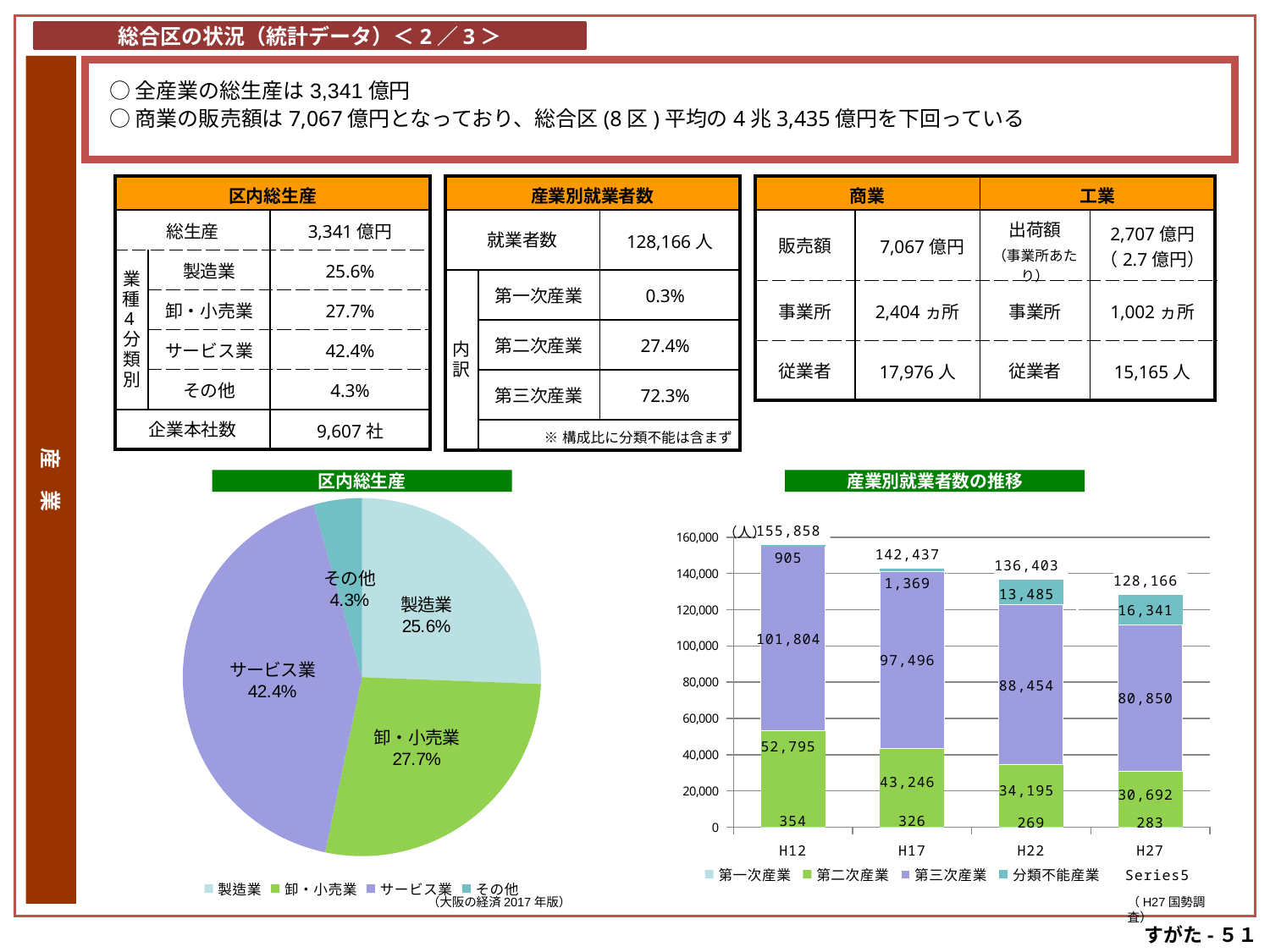
In the pie chart titled 区内総生産, which category has the largest share? サービス業 In the chart titled 産業別就業者数の推移, what is the difference between the 分類不能産業 values for H27 and H22? 2,856 In the pie chart titled 区内総生産, what share does サービス業 have? 42.4% In the chart titled 産業別就業者数の推移, what is the total for H17? 142,437 In the chart titled 産業別就業者数の推移, what is the value for 第三次産業 in H22? 88,454 In the chart titled 産業別就業者数の推移, do the total values rise or fall from H12 to H27? Fall In the pie chart titled 区内総生産, which category has the smallest share? その他 In the chart titled 産業別就業者数の推移, which is larger: 第二次産業 in H12 or 第二次産業 in H27? 第二次産業 in H12 What kind of chart is the chart titled 産業別就業者数の推移? Stacked bar chart In the chart titled 産業別就業者数の推移, how many series does the legend list? 5 In the pie chart titled 区内総生産, what is the difference between the shares of 卸・小売業 and 製造業? 2.1% In the pie chart titled 区内総生産, how many slices are there? 4